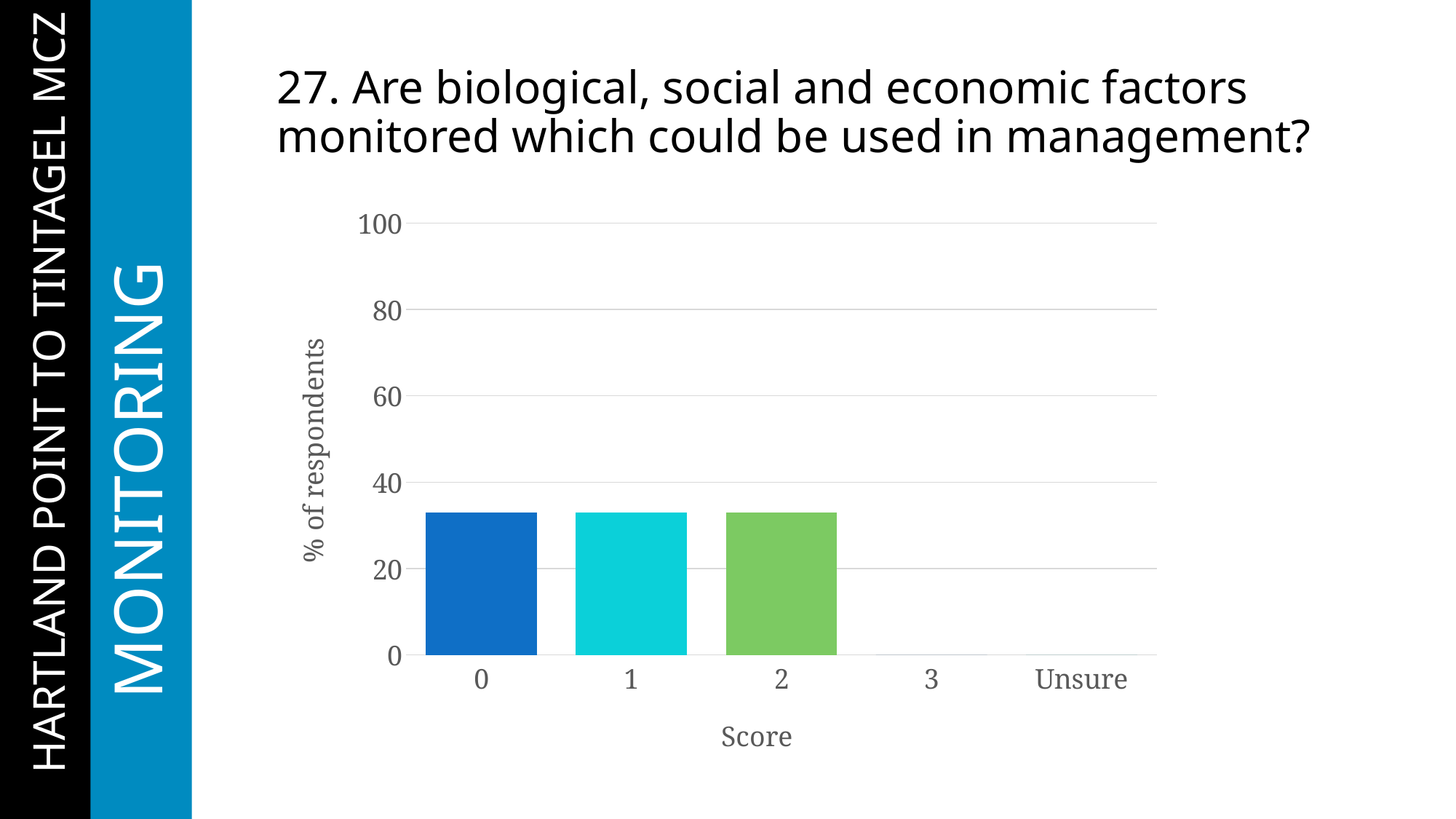
Is the value for score 1 greater or less than 20? greater What is the value for Unsure? 0 Is the value for score 0 greater or less than 40? less What is the label of the y axis? % of respondents How many categories are shown on the x axis of the chart? 5 Which is larger, the value for score 2 or the value for Unsure? 2 What kind of chart is shown on the slide? bar chart How many categories have a value of 0? 2 What is the value for score 3? 0 What is the label of the x axis? Score Is the value for score 2 greater or less than 40? less Which is larger, the value for score 0 or the value for score 3? 0